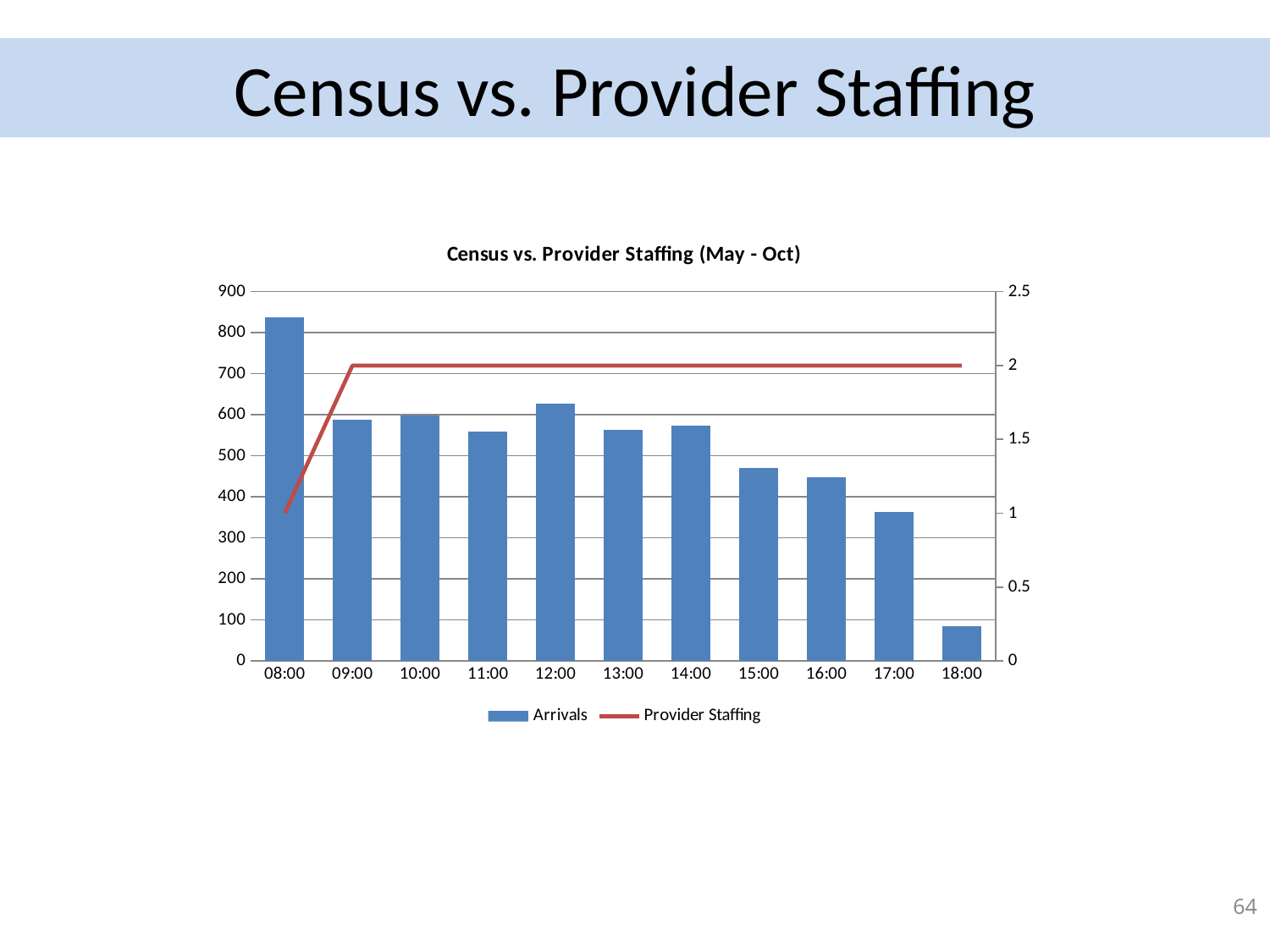
How many time categories are shown on the x axis? 11 Which time has the lowest number of Arrivals? 18:00 How many series does the legend list? 2 Do the Arrivals values rise or fall from 14:00 to 18:00? fall Is the Arrivals value at 08:00 greater or less than 800? greater What is the Provider Staffing value at 14:00? 2 Is the Arrivals value at 17:00 greater or less than 400? less What type of chart is shown on the slide? A combination bar and line chart What is the Provider Staffing value at 08:00? 1 Which time has the highest number of Arrivals? 08:00 What is the title of the chart? Census vs. Provider Staffing (May - Oct) Which has more Arrivals, 12:00 or 15:00? 12:00